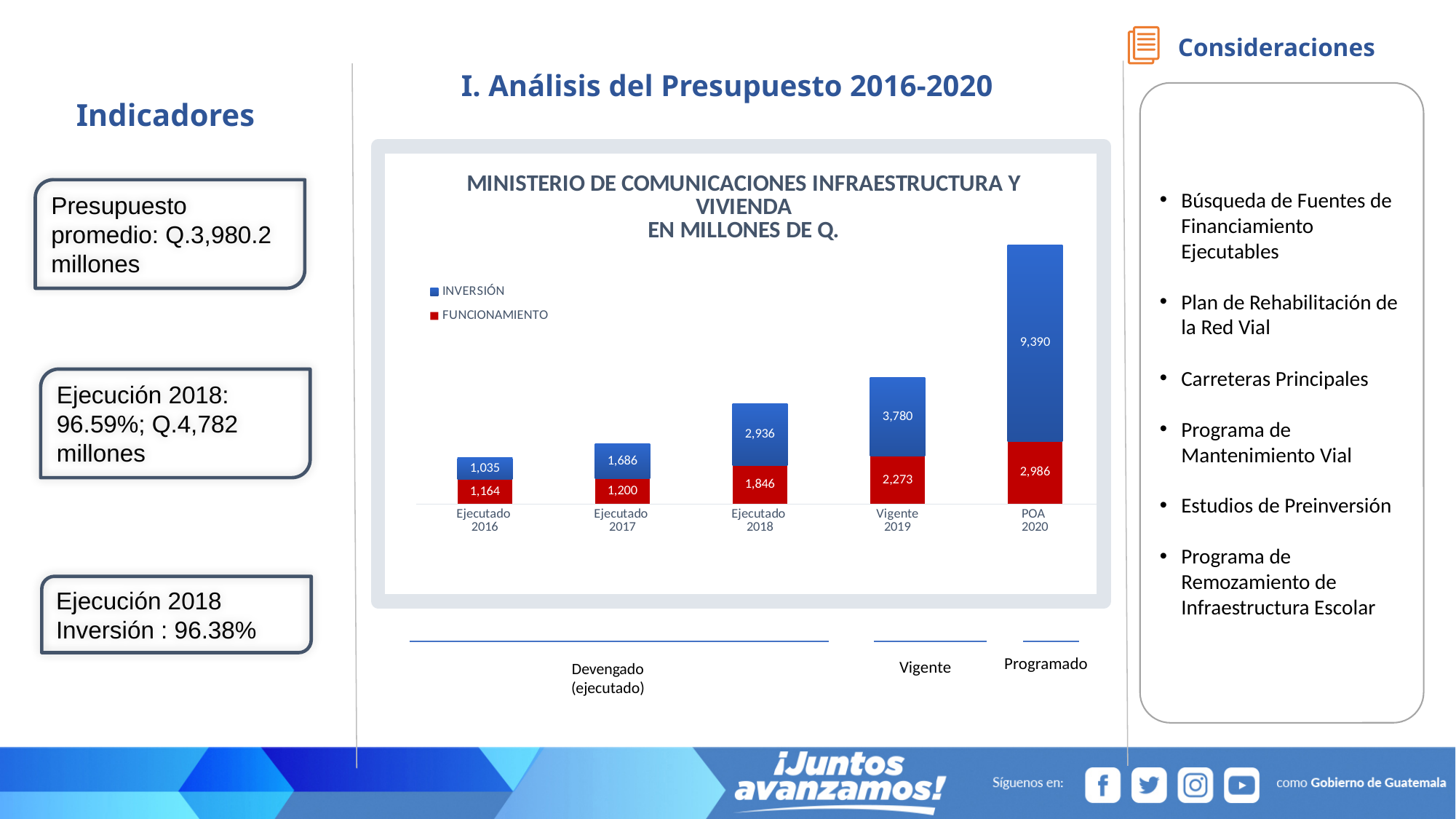
Which category has the lowest FUNCIONAMIENTO value? Ejecutado 2016 What is the INVERSIÓN value for Vigente 2019? 3,780 What is the difference between the INVERSIÓN values for POA 2020 and Vigente 2019? 5,610 Which is larger for Ejecutado 2016: INVERSIÓN or FUNCIONAMIENTO? FUNCIONAMIENTO How many series does the legend list? 2 What is the total of the stacked bar for Ejecutado 2018? 4,782 What is the FUNCIONAMIENTO value for Ejecutado 2018? 1,846 What kind of chart is shown? Stacked bar chart Which category has the highest INVERSIÓN value? POA 2020 What is the INVERSIÓN value for POA 2020? 9,390 Do the INVERSIÓN values rise or fall from Ejecutado 2016 to POA 2020? Rise How many categories are shown on the x axis? 5